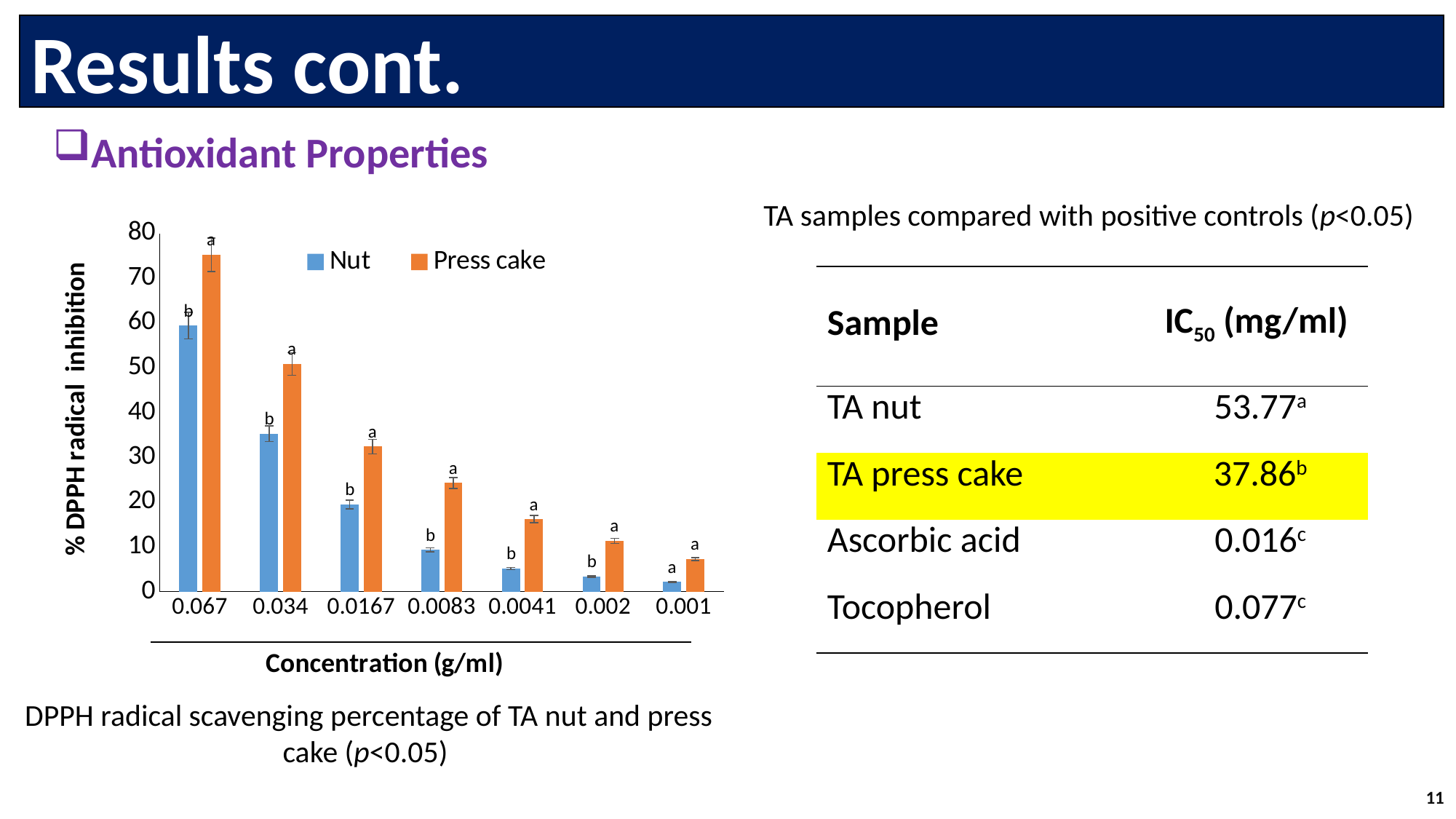
How many concentration categories are shown on the x axis of the chart? 7 Do the Nut values rise or fall moving from left to right along the x axis? fall At which concentration is the Press cake bar highest? 0.067 What is the label of the y axis of the chart? % DPPH radical inhibition Is the Press cake value at concentration 0.0083 greater or less than 20? greater Is the Nut value at concentration 0.034 greater or less than 40? less What kind of chart is shown on the slide? bar chart Is the Press cake value at concentration 0.067 greater or less than 70? greater At which concentration is the Nut bar lowest? 0.001 At concentration 0.0041, which series has the larger value, Nut or Press cake? Press cake Which series does the orange bar represent in the chart? Press cake How many series does the chart's legend list? 2